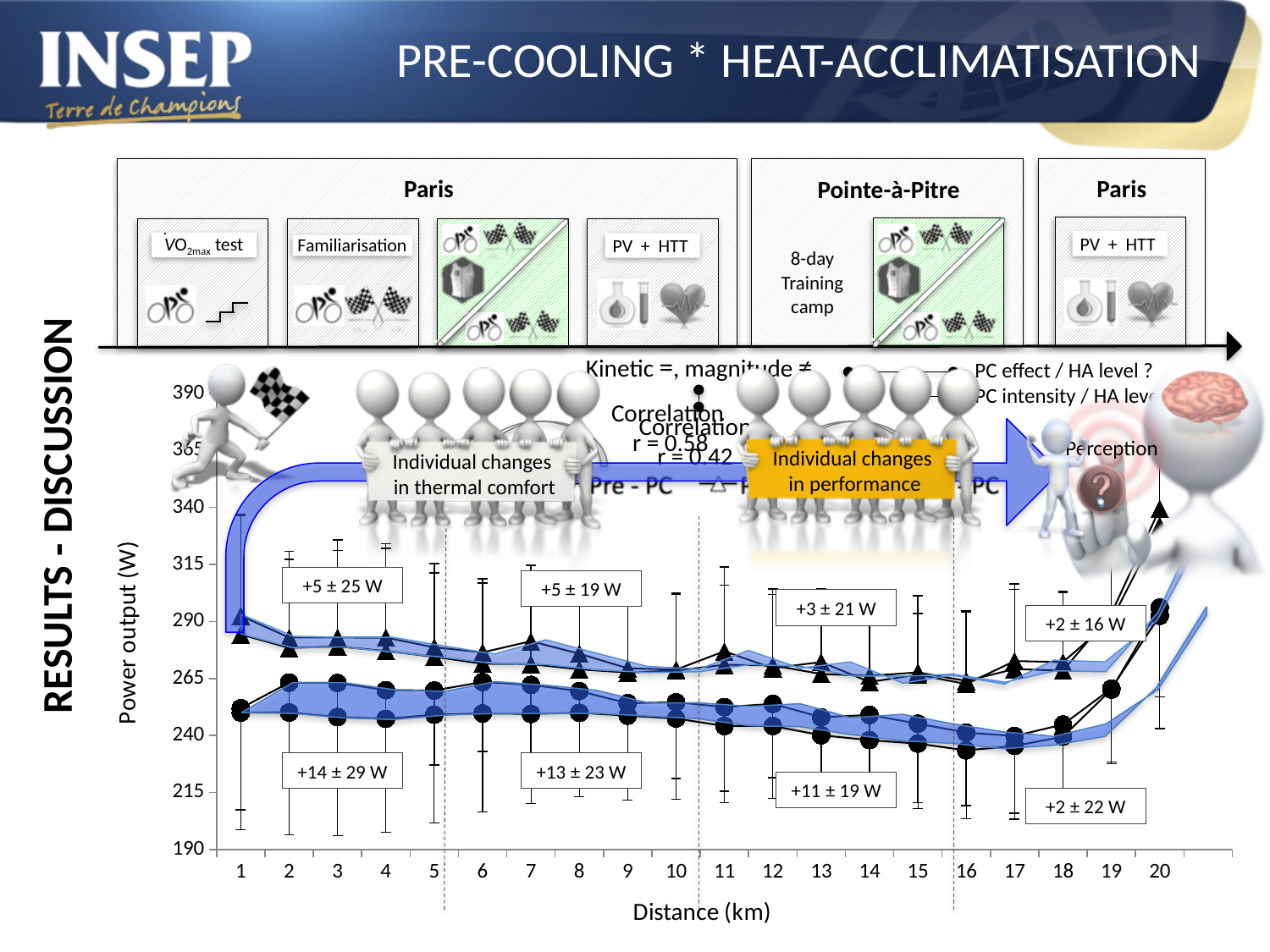
What change in power output is annotated for the lower (circle) series in the last segment (km 16-20)? +2 ± 22 W What change in power output is annotated for the lower (circle) series in the first segment (km 1-5)? +14 ± 29 W What change in power output is annotated for the upper (triangle) series in the third segment (km 11-15)? +3 ± 21 W What is the label of the y axis of the chart? Power output (W) Is the power output of the circle-marker series at km 1 greater or less than 265 W? less What change in power output is annotated for the lower (circle) series in the second segment (km 6-10)? +13 ± 23 W How many distance points are marked along the x axis of the chart? 20 What change in power output is annotated for the upper (triangle) series in the first segment (km 1-5)? +5 ± 25 W Is the power output of the triangle-marker series at km 20 greater or less than 315 W? greater What is the label of the x axis of the chart? Distance (km) What kind of chart is shown on the slide? line chart Between km 16 and km 20, does the power output of the triangle-marker series rise or fall? rise